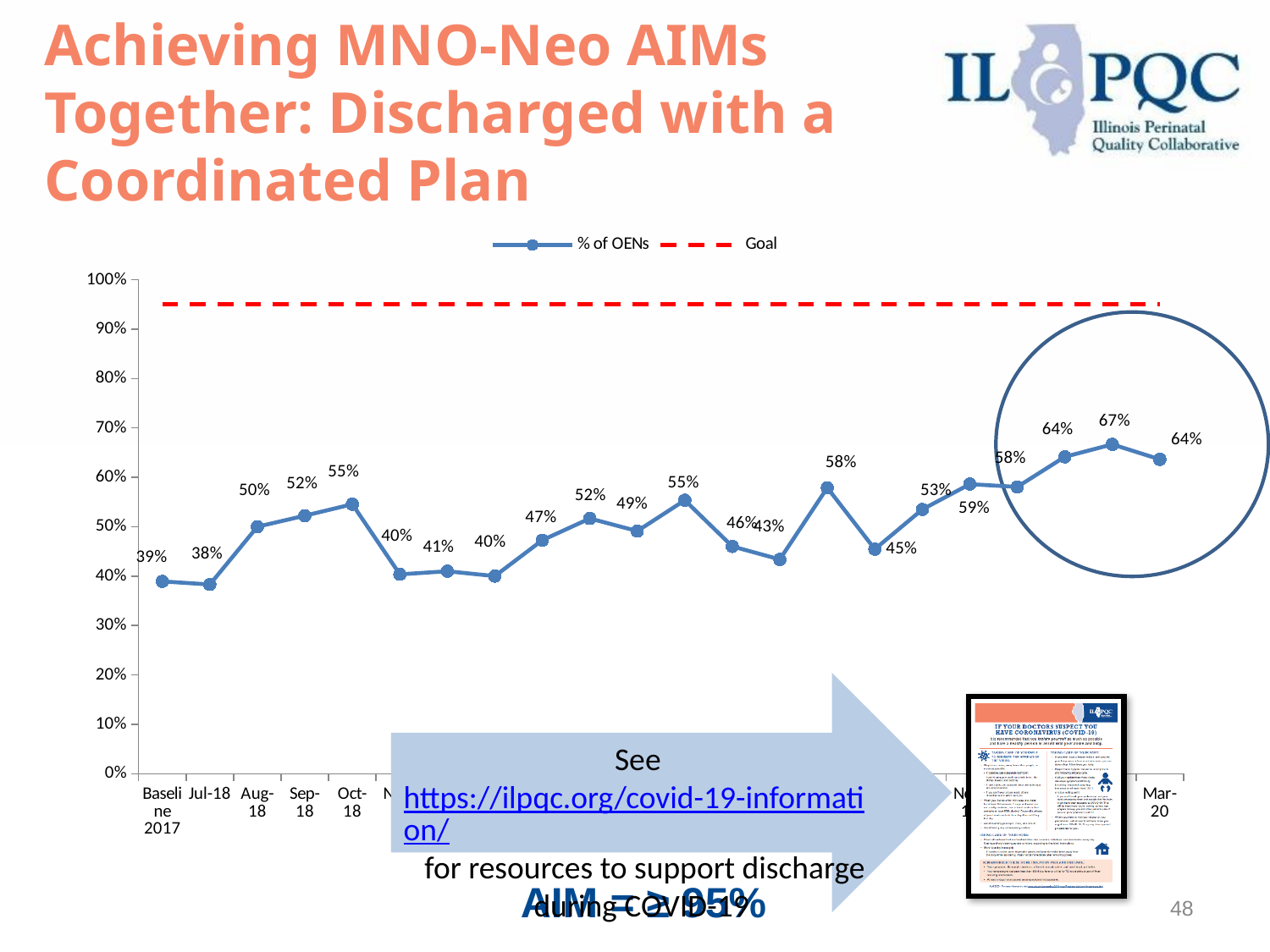
Is the Goal line greater or less than 90%? greater What is the % of OENs value for Oct-18? 55% What is the highest % of OENs value plotted on the chart? 67% What is the % of OENs value for Jul-18? 38% What is the % of OENs value for Aug-18? 50% What is the difference between the % of OENs values for Mar-20 and Baseline 2017? 25% Which has a higher % of OENs value, Sep-18 or Oct-18? Oct-18 What is the % of OENs value for Baseline 2017? 39% How many series does the chart legend list? 2 What is the % of OENs value for Mar-20? 64% What is the lowest % of OENs value plotted on the chart? 38% What type of chart is shown on the slide? line chart